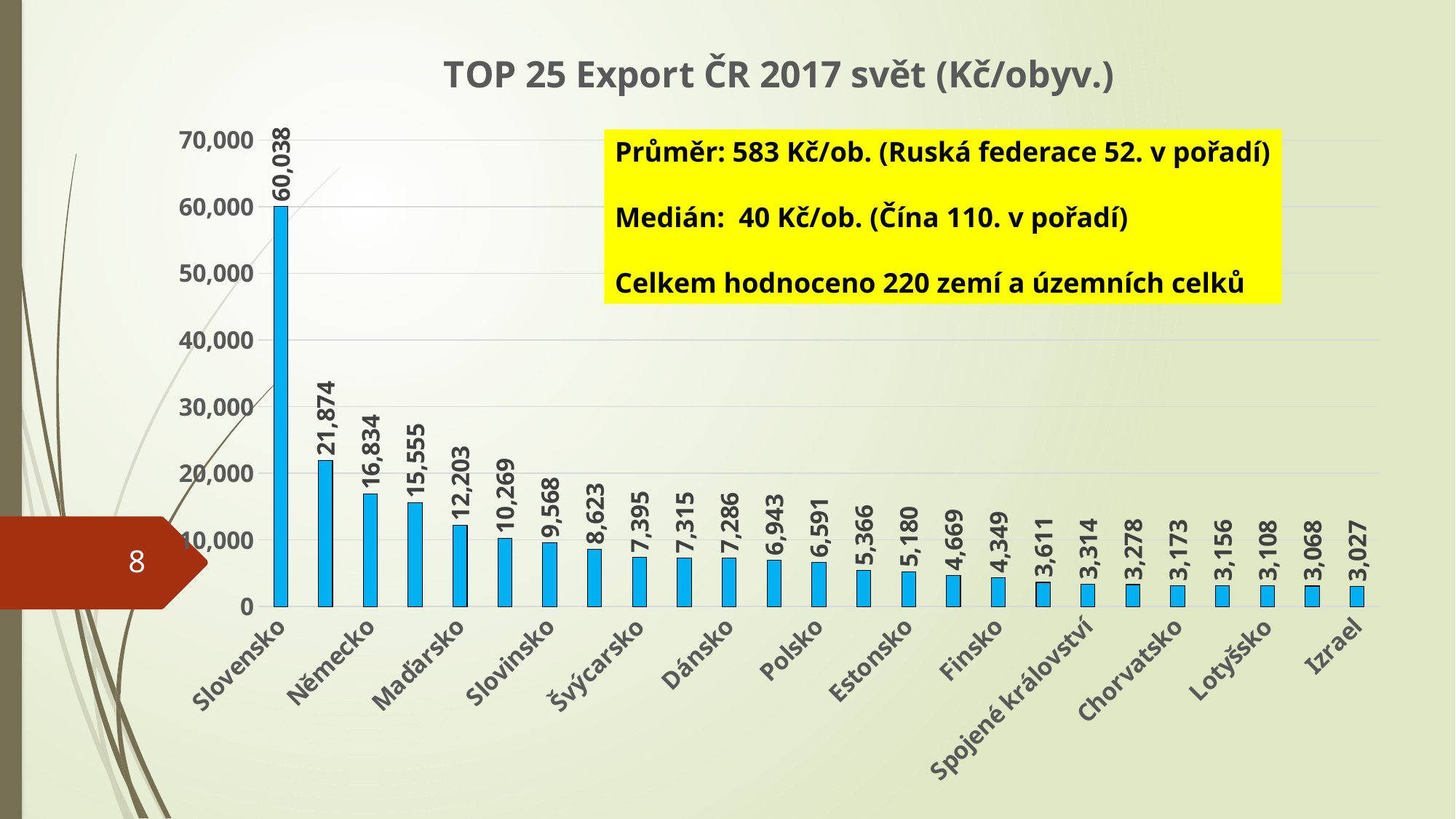
What is the value for Německo? 16,834 Which country has the highest value? Slovensko What is the difference between the values for Slovensko and Izrael? 57,011 What is the title of the chart? TOP 25 Export ČR 2017 svět (Kč/obyv.) Which country has the lowest value? Izrael What is the value for Slovensko? 60,038 Do the values rise or fall from left to right along the x axis? fall How many bars are plotted in the chart? 25 What is the value for Izrael? 3,027 Is the value for Slovensko greater or less than 50,000? greater What kind of chart is shown? bar chart Which is larger, the value for Slovensko or the value for Německo? Slovensko